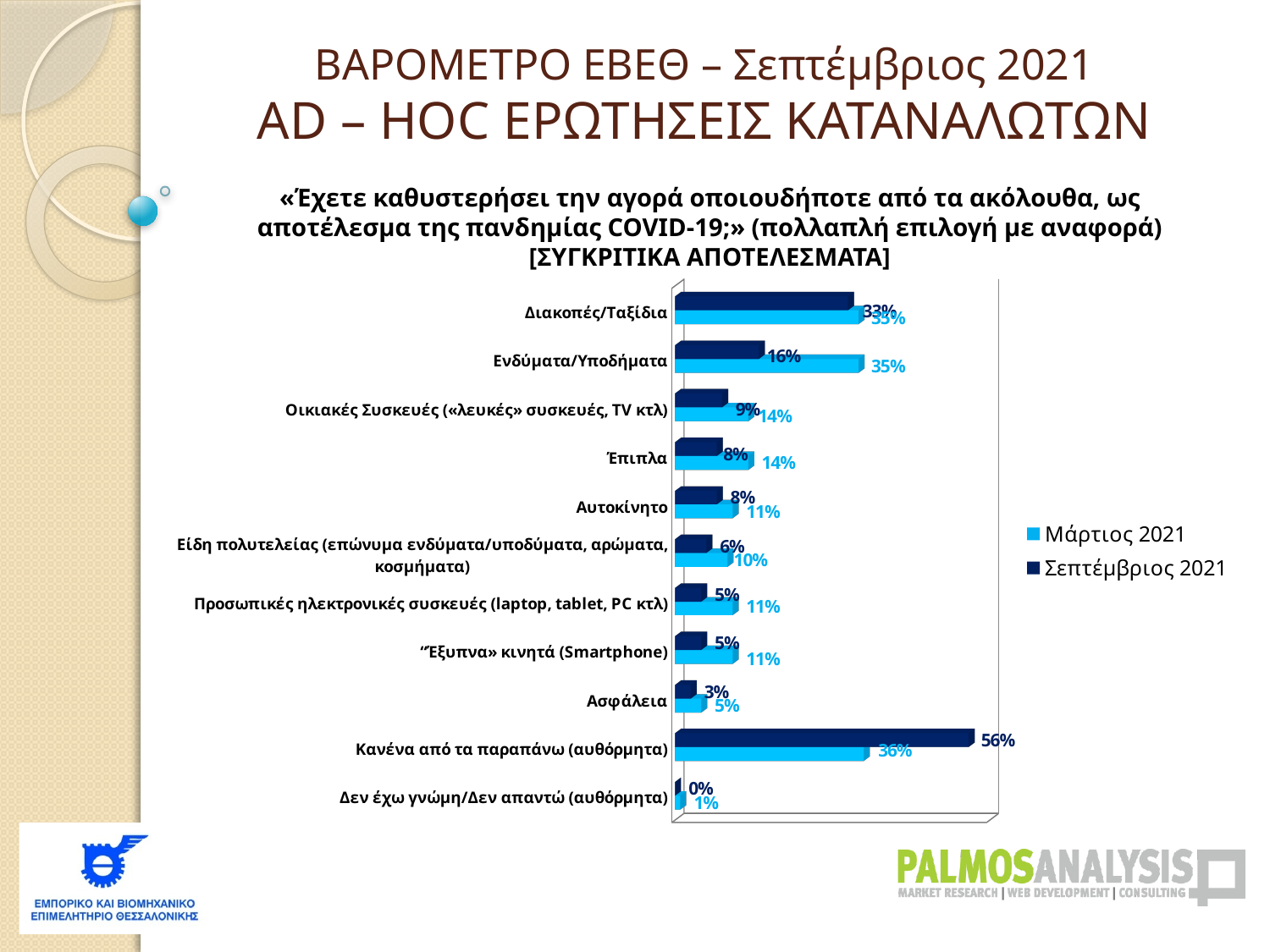
What is the difference between the Μάρτιος 2021 and Σεπτέμβριος 2021 values for Ενδύματα/Υποδήματα? 19% What is the value for Ασφάλεια in the Μάρτιος 2021 series? 5% Which category has the highest value in the Σεπτέμβριος 2021 series? Κανένα από τα παραπάνω (αυθόρμητα) What is the value for Κανένα από τα παραπάνω (αυθόρμητα) in the Σεπτέμβριος 2021 series? 56% What kind of chart is shown on the slide? bar chart How many series does the legend list? 2 What is the value for Ενδύματα/Υποδήματα in the Σεπτέμβριος 2021 series? 16% For Έπιπλα, which series has the larger value, Μάρτιος 2021 or Σεπτέμβριος 2021? Μάρτιος 2021 What is the value for Ενδύματα/Υποδήματα in the Μάρτιος 2021 series? 35% How many categories are shown in the chart? 11 Which category has the lowest value in the Μάρτιος 2021 series? Δεν έχω γνώμη/Δεν απαντώ (αυθόρμητα) Which colour represents the Σεπτέμβριος 2021 series in the chart? dark blue